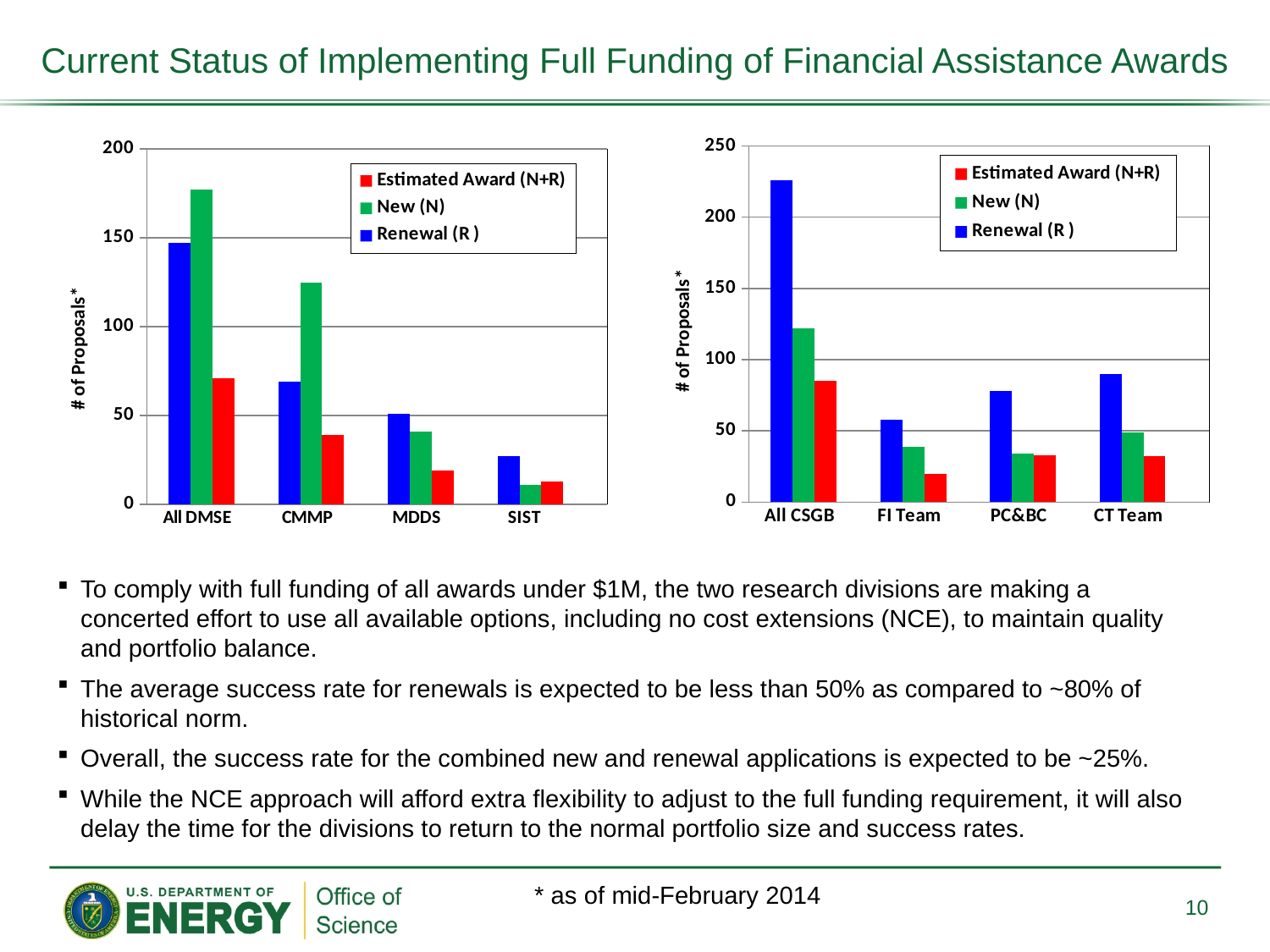
In the right chart (All CSGB, FI Team, PC&BC, CT Team), is the Renewal (R) value for All CSGB greater or less than 200? greater In the left chart (All DMSE, CMMP, MDDS, SIST), is the Renewal (R) value for All DMSE greater or less than 100? greater In the left chart (All DMSE, CMMP, MDDS, SIST), how many categories are shown on the x axis? 4 In the right chart (All CSGB, FI Team, PC&BC, CT Team), how many categories are shown on the x axis? 4 In the left chart (All DMSE, CMMP, MDDS, SIST), is the New (N) value for SIST greater or less than 50? less In the left chart (All DMSE, CMMP, MDDS, SIST), which category has the highest New (N) value? All DMSE In the left chart (All DMSE, CMMP, MDDS, SIST), how many series does the legend list? 3 In the right chart (All CSGB, FI Team, PC&BC, CT Team), what is the y-axis title? # of Proposals* In the right chart (All CSGB, FI Team, PC&BC, CT Team), which category has the highest Renewal (R) value? All CSGB What kind of chart is the left chart (with categories All DMSE, CMMP, MDDS, SIST)? bar chart In the right chart (All CSGB, FI Team, PC&BC, CT Team), which category has the lowest Estimated Award (N+R) value? FI Team In the left chart (All DMSE, CMMP, MDDS, SIST), for CMMP, which is larger: New (N) or Renewal (R)? New (N)